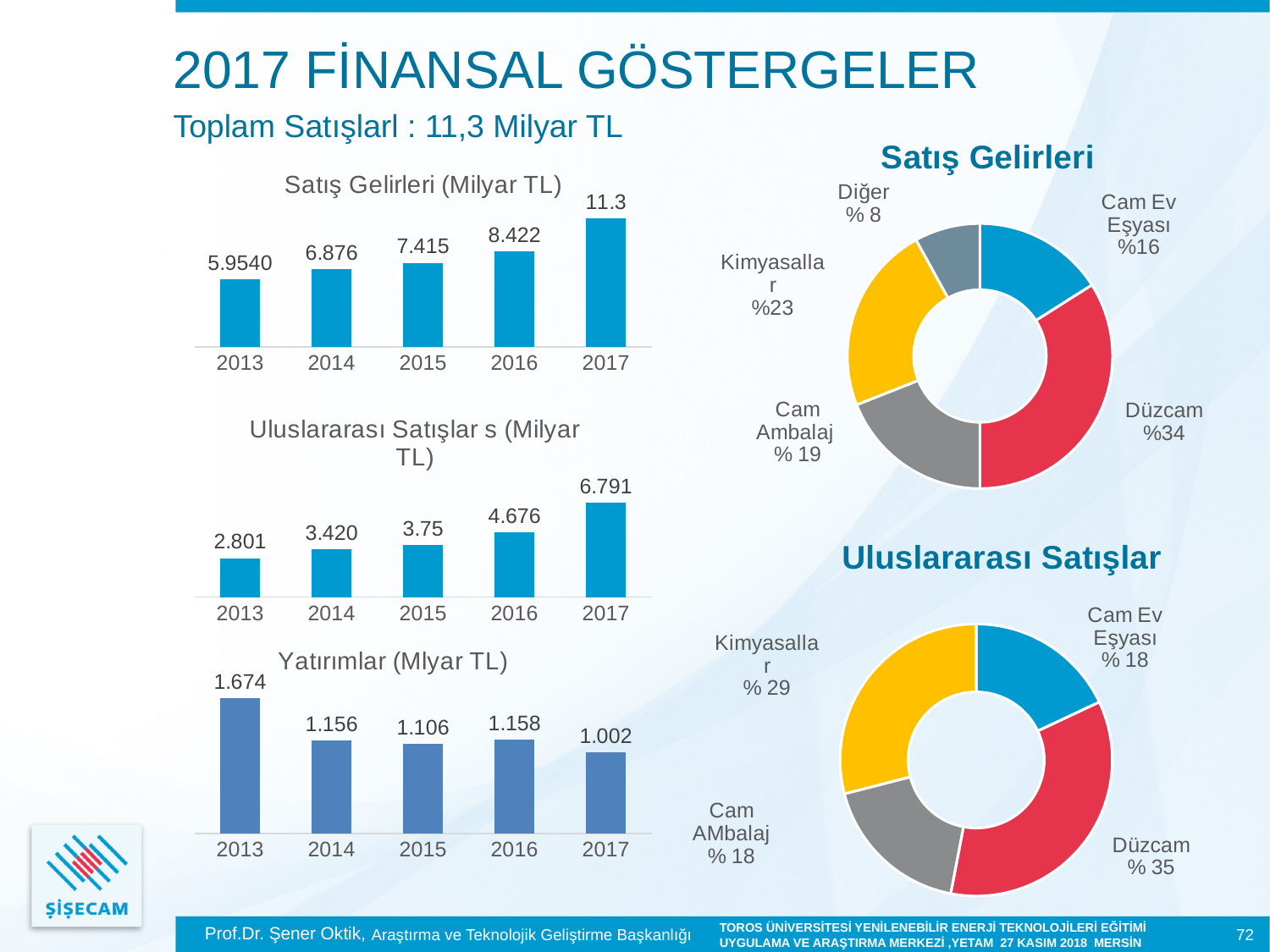
In the 'Yatırımlar (Mlyar TL)' bar chart, how many years are shown? 5 In the 'Uluslararası Satışlar s (Milyar TL)' bar chart, what is the value for 2016? 4.676 In the 'Satış Gelirleri (Milyar TL)' bar chart, do the values rise or fall from 2013 to 2017? rise In the 'Uluslararası Satışlar s (Milyar TL)' bar chart, what is the difference between the 2017 and 2013 values? 3.990 In the 'Satış Gelirleri (Milyar TL)' bar chart, what is the value for 2017? 11.3 In the 'Satış Gelirleri' doughnut chart, what share does Düzcam have? %34 In the 'Uluslararası Satışlar' doughnut chart, what share does Kimyasallar have? % 29 In the 'Satış Gelirleri (Milyar TL)' bar chart, which year has the lowest value? 2013 In the 'Yatırımlar (Mlyar TL)' bar chart, what is the value for 2015? 1.106 In the 'Satış Gelirleri' doughnut chart, which segment is the smallest? Diğer In the 'Yatırımlar (Mlyar TL)' bar chart, which year has the highest value? 2013 In the 'Uluslararası Satışlar' doughnut chart, how many segments are there? 4